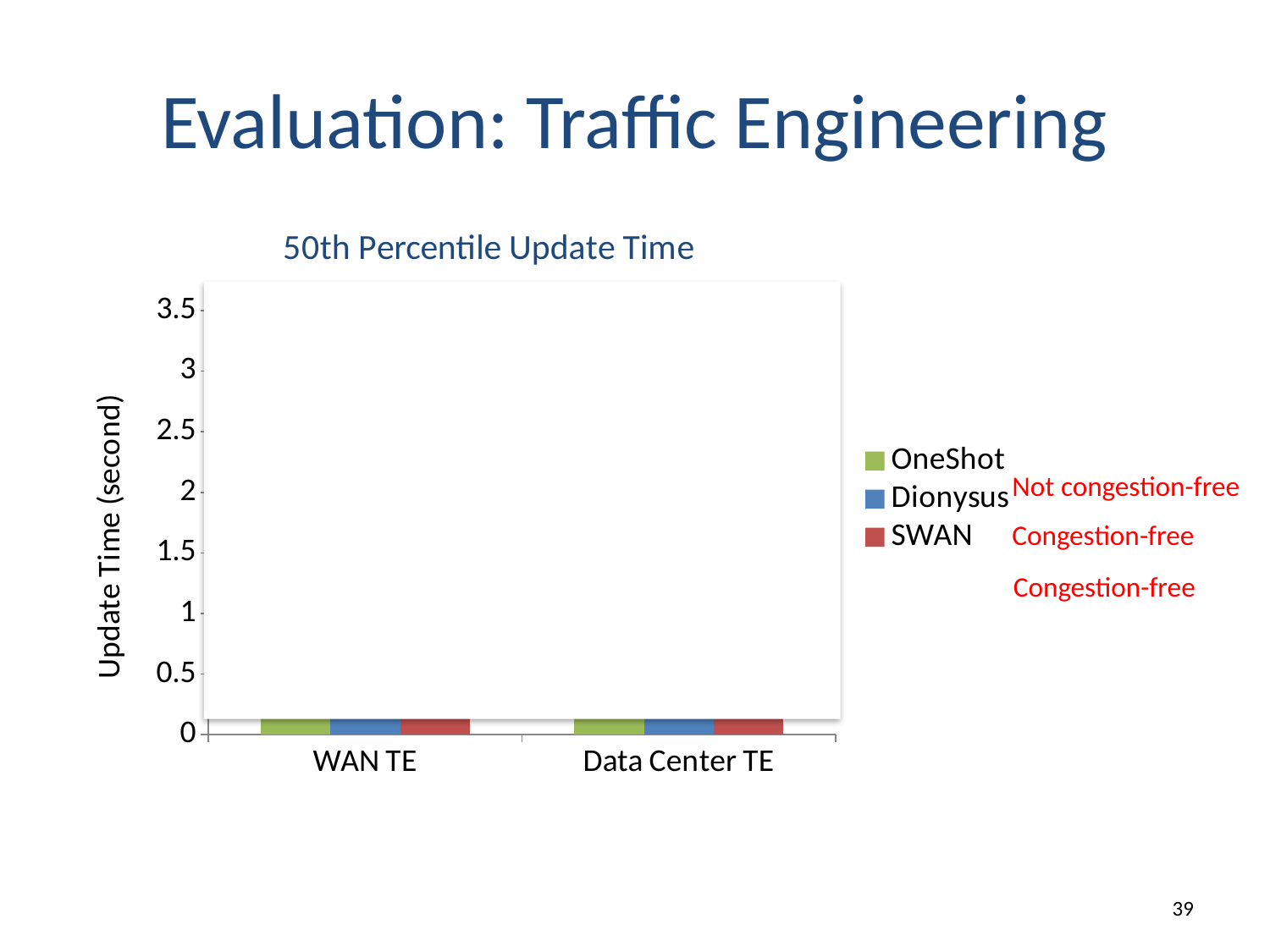
What is the label of the y axis? Update Time (second) What kind of chart is shown on the slide? bar chart What is the title of the chart? 50th Percentile Update Time How many categories are shown on the x axis? 2 How many series does the legend list? 3 Is the value for Dionysus in WAN TE greater or less than 1.5? less